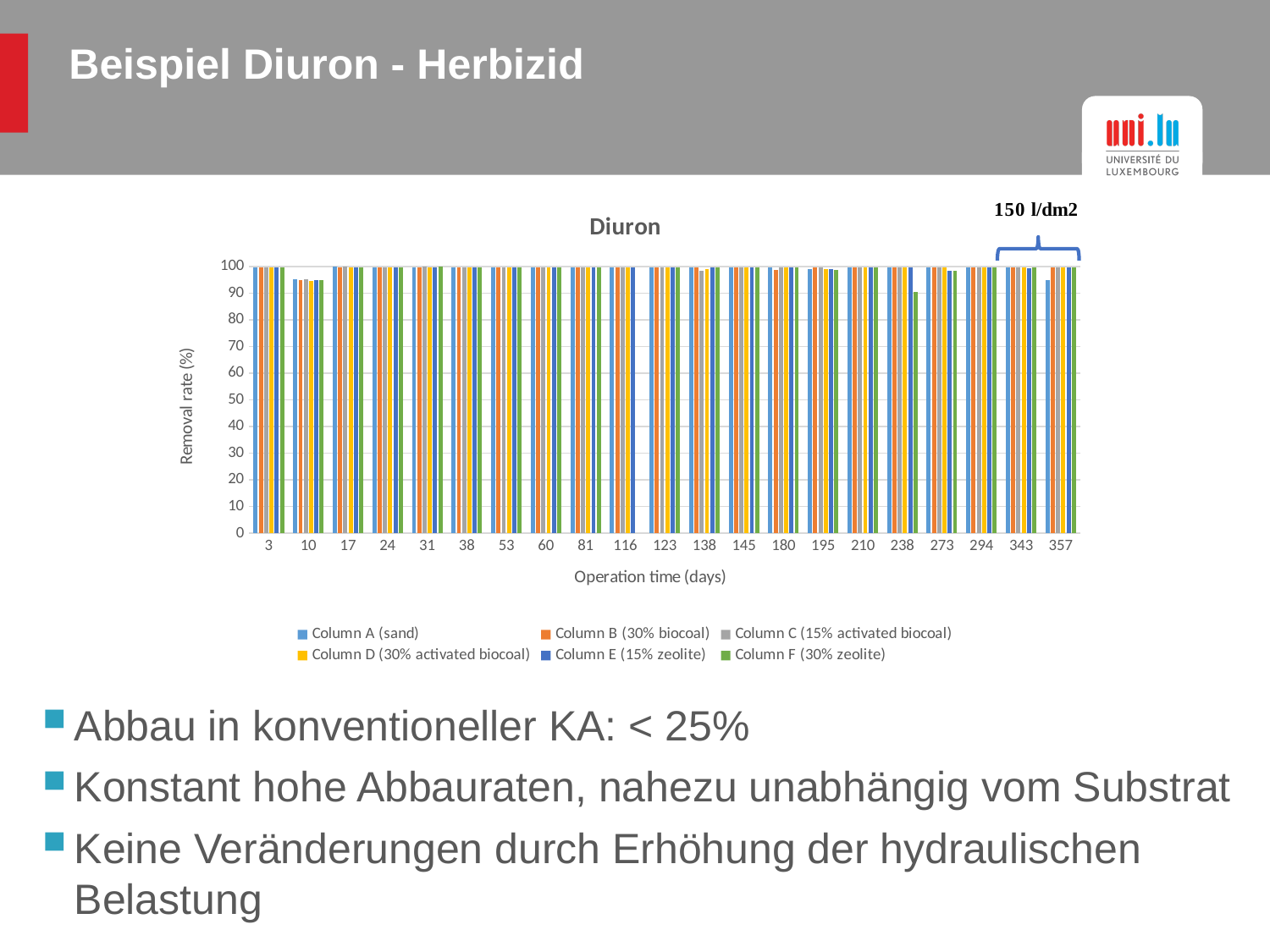
What kind of chart is shown on the slide? bar chart Is the value for Column E (15% zeolite) at 357 days greater or less than 90? greater Is the value for Column A (sand) at 10 days greater or less than 80? greater How many operation-time categories are shown on the x axis? 21 What is the label of the y axis? Removal rate (%) How many series does the legend list? 6 Which is larger at 238 days: the value for Column A (sand) or the value for Column F (30% zeolite)? Column A (sand) Is the value for Column B (30% biocoal) at 3 days greater or less than 50? greater What is the title of the chart? Diuron What is the first category on the x axis? 3